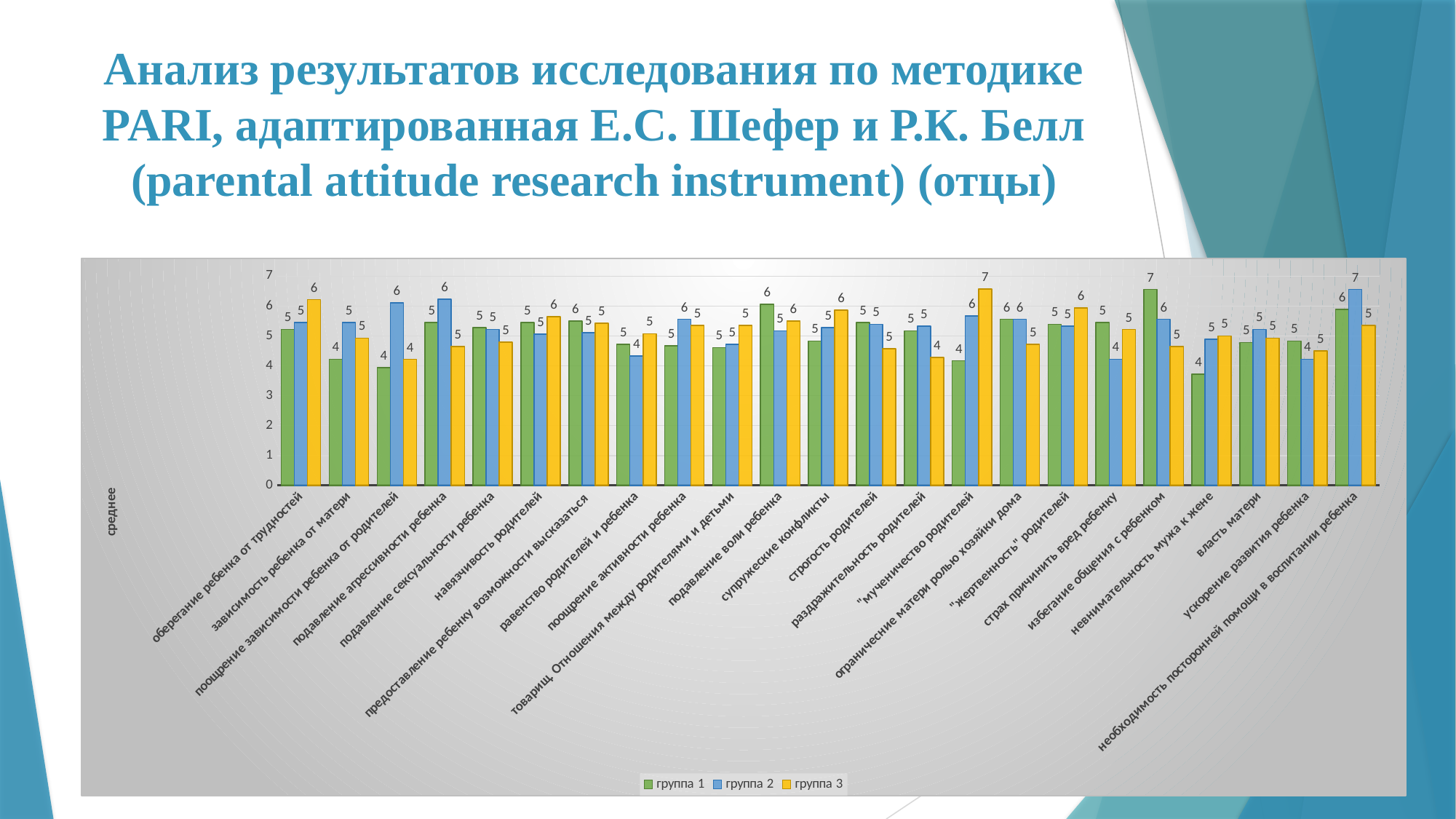
How many categories are shown on the x axis of the chart? 23 How many series does the legend list? 3 In which category does группа 3 reach its highest value? "мученичество родителей" Which colour represents группа 2 in the chart? blue What is the value for группа 3 in the category "мученичество родителей"? 7 What is the value for группа 2 in the category "поощрение зависимости ребенка от родителей"? 6 What kind of chart is shown on the slide? bar chart What is the value for группа 3 in the category "раздражительность родителей"? 4 What is the value for группа 1 in the category "избегание общения с ребенком"? 7 What is the difference between the группа 3 and группа 1 values in the category "мученичество родителей"? 3 In the category "мученичество родителей", which is larger: the value for группа 1 or for группа 3? группа 3 In which category does группа 2 reach its highest value? необходимость посторонней помощи в воспитании ребенка